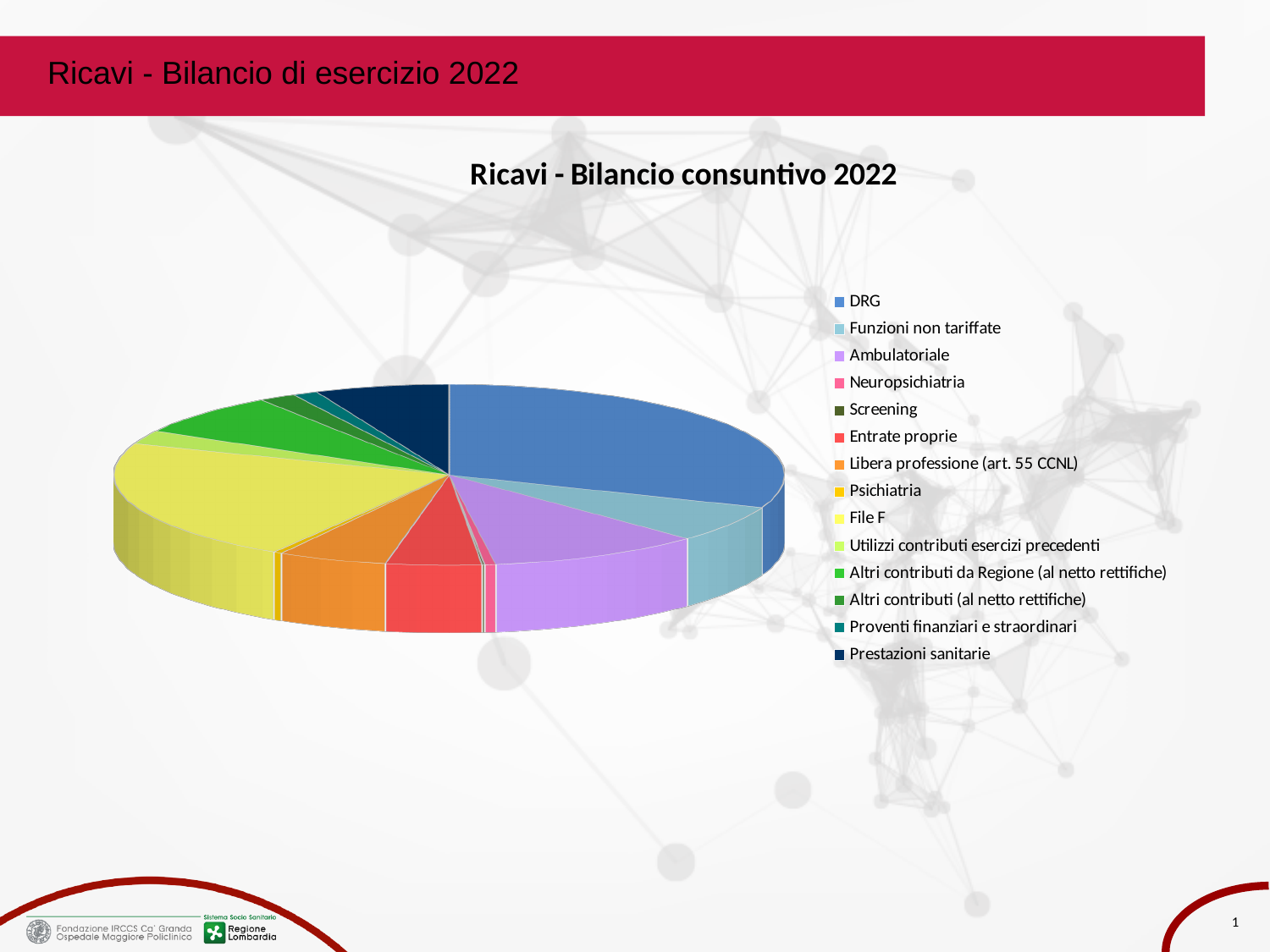
What is the title of the chart? Ricavi - Bilancio consuntivo 2022 What is the first category listed in the legend? DRG Which category has the largest slice of the pie? DRG What kind of chart is shown on the slide? pie chart How many categories does the legend of the pie chart list? 14 Which slice is larger, Utilizzi contributi esercizi precedenti or Entrate proprie? Entrate proprie Which slice is larger, Ambulatoriale or Neuropsichiatria? Ambulatoriale Which slice is larger, DRG or Ambulatoriale? DRG